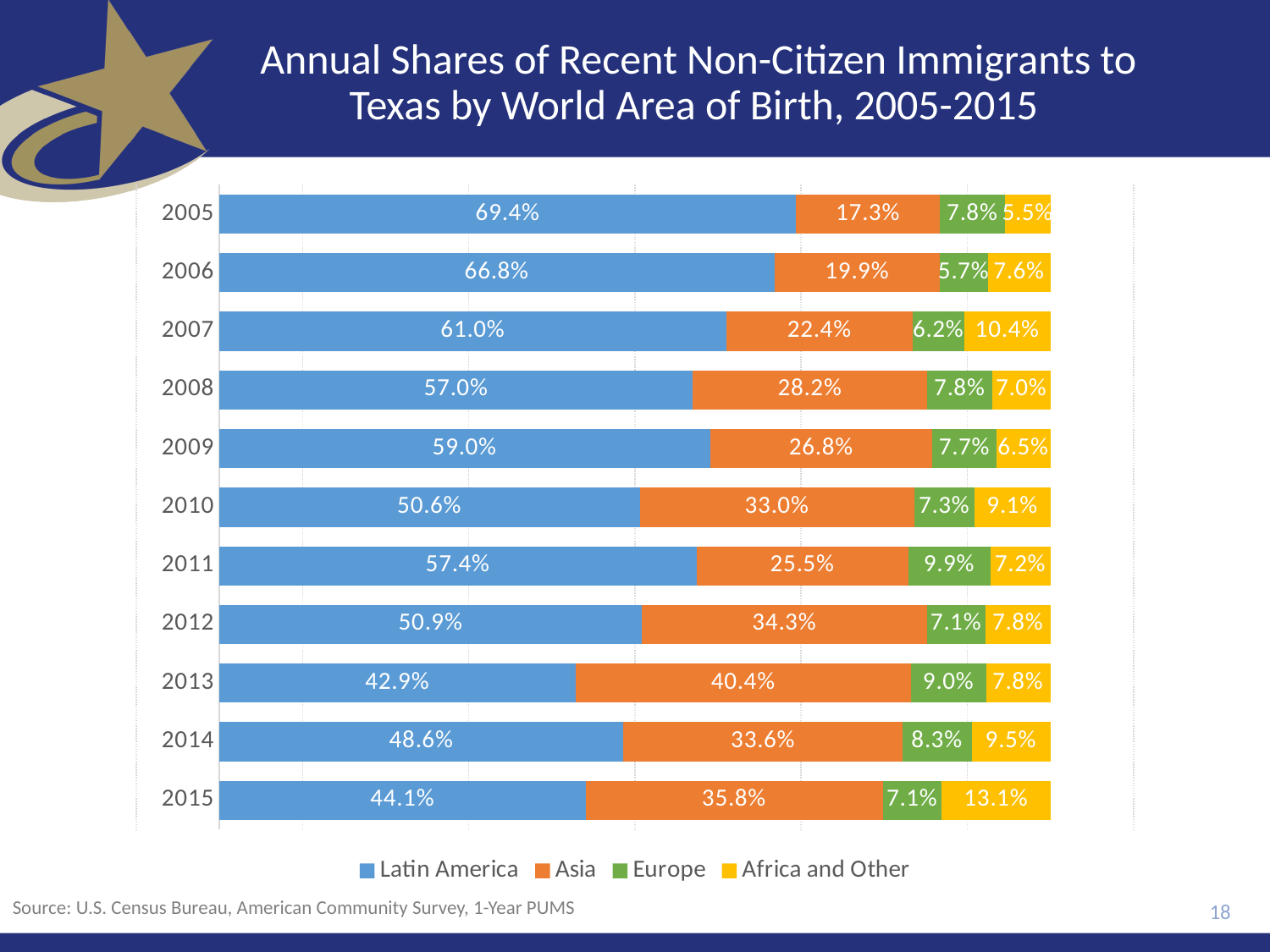
Which year has the lowest Latin America share? 2013 What is the Africa and Other share for 2015? 13.1% What kind of chart is shown on the slide? Stacked bar chart What is the Europe share for 2011? 9.9% What is the Asia share for 2013? 40.4% Which year has the highest Latin America share? 2005 What is the difference between the Latin America share in 2005 and in 2015? 25.3% Which year has the highest Asia share? 2013 What is the Latin America share for 2005? 69.4% How many years are shown in the chart? 11 How many series does the legend list? 4 Which is larger in 2010: the Asia share or the Latin America share? Latin America